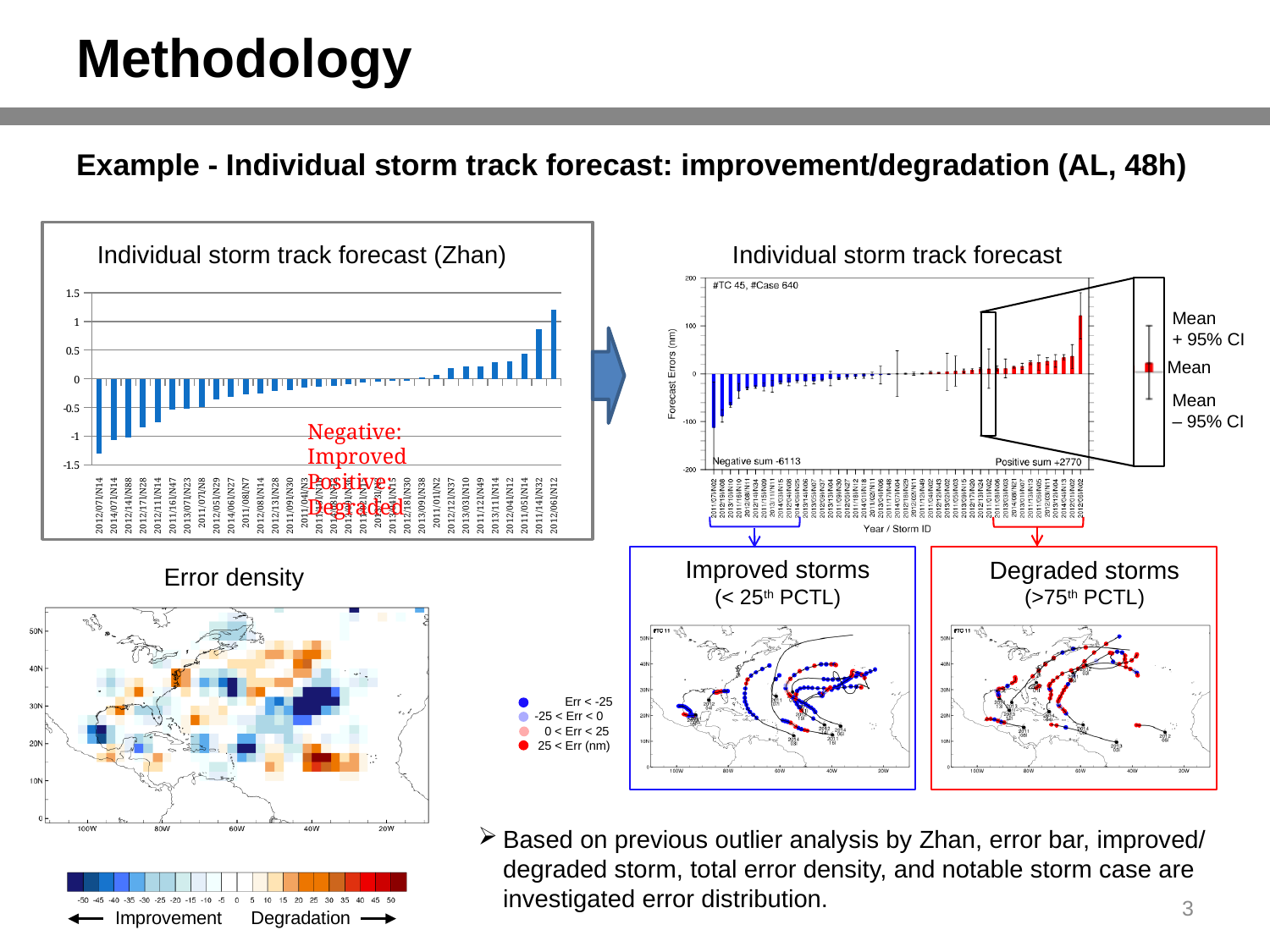
In the 'Individual storm track forecast' chart on the right, what is the y-axis label? Forecast Errors (nm) In the 'Individual storm track forecast (Zhan)' chart, is the value for 2012/07/N14 greater or less than -1? less In the 'Individual storm track forecast (Zhan)' chart, which is larger, the value for 2012/06/N12 or the value for 2012/07/N14? 2012/06/N12 In the 'Individual storm track forecast (Zhan)' chart, which storm has the lowest value? 2012/07l/N14 What kind of chart is 'Individual storm track forecast (Zhan)'? bar chart How many error categories does the legend for the 'Improved storms' and 'Degraded storms' maps list? 4 In the 'Individual storm track forecast' chart on the right, what is the negative sum shown? -6113 In the 'Individual storm track forecast' chart on the right, what is the positive sum shown? +2770 In the 'Individual storm track forecast (Zhan)' chart, is the value for 2012/06/N12 greater or less than 1? greater In the 'Individual storm track forecast' chart on the right, how many TCs and cases are stated in the annotation? #TC 45, #Case 640 In the 'Individual storm track forecast (Zhan)' chart, which storm has the highest value? 2012/06l/N12 In the 'Individual storm track forecast (Zhan)' chart, do the bar values rise or fall from left to right along the x axis? rise